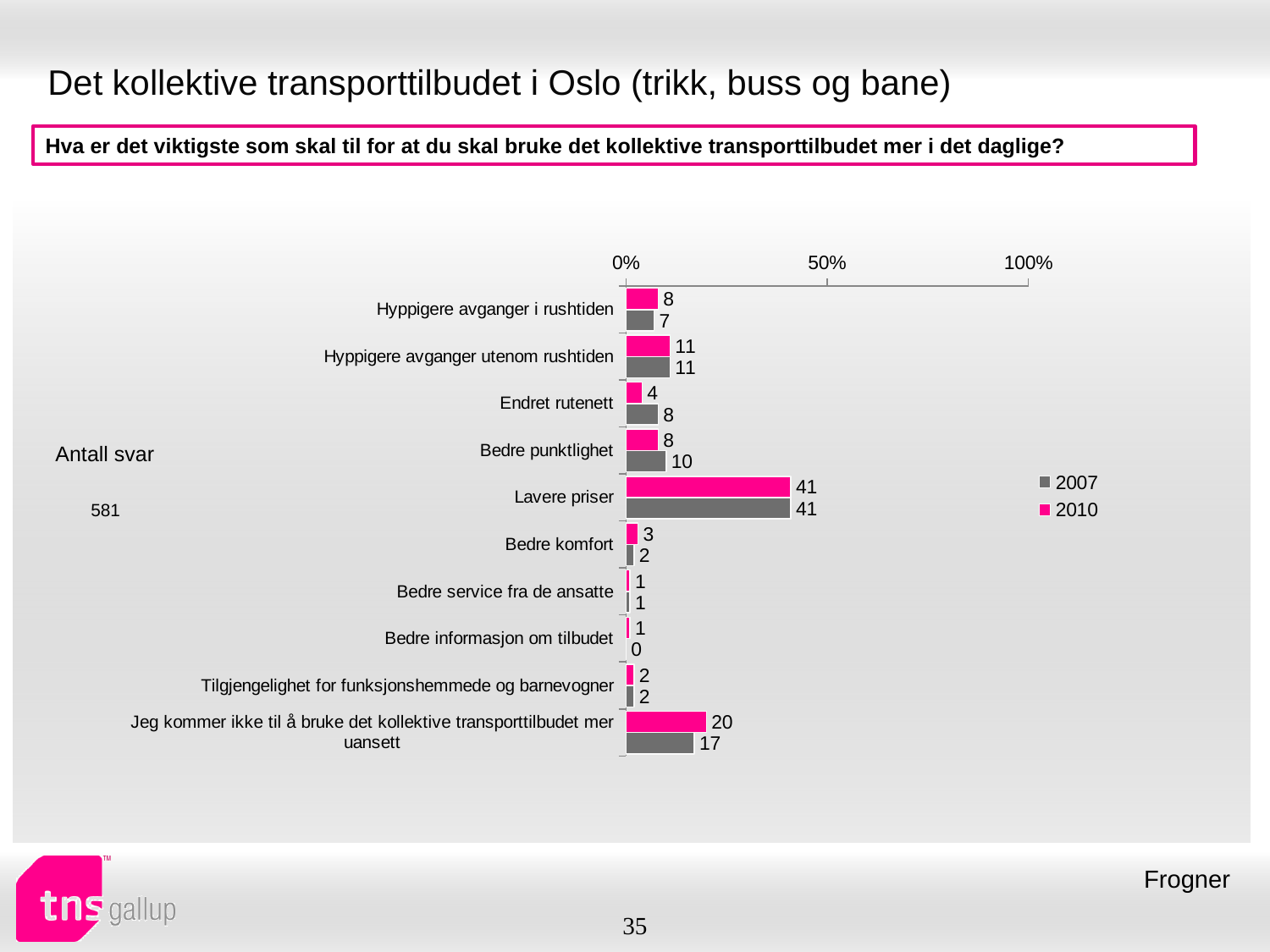
How many series does the legend list? 2 What is the 2007 value for "Bedre informasjon om tilbudet"? 0 What is the difference between the 2010 and 2007 values for "Jeg kommer ikke til å bruke det kollektive transporttilbudet mer uansett"? 3 What is the 2010 value for "Lavere priser"? 41 What kind of chart is shown on the slide? Bar chart Which category has the highest 2010 value? Lavere priser What is the 2007 value for "Bedre punktlighet"? 10 What is the difference between the 2007 and 2010 values for "Endret rutenett"? 4 What is the 2010 value for "Endret rutenett"? 4 Which is larger for "Bedre komfort": the 2007 value or the 2010 value? 2010 How many categories are shown in the chart? 10 Is the 2010 value for "Lavere priser" greater or less than 50%? less